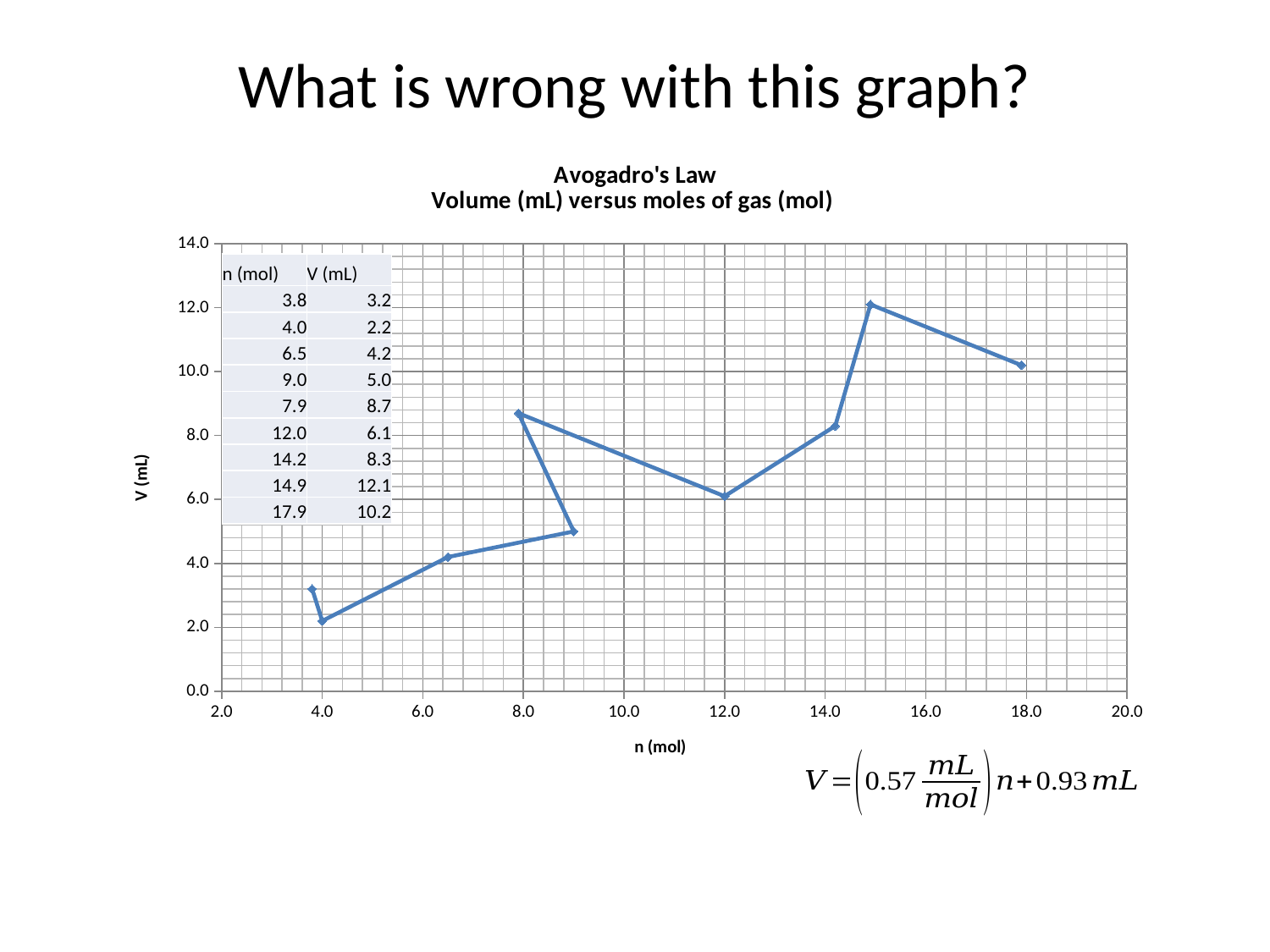
What is the difference in volume between n = 14.9 mol and n = 17.9 mol? 1.9 What type of chart is shown on the slide? line chart How many data points are plotted on the chart? 9 Which has the larger volume, n = 14.2 mol or n = 12.0 mol? n = 14.2 mol What is the label of the vertical axis? V (mL) Is the volume at n = 7.9 mol greater or less than 8.0 mL? greater What is the volume V (mL) at n = 14.9 mol? 12.1 What is the volume V (mL) at n = 7.9 mol? 8.7 At which value of n (mol) is the volume lowest? 4.0 What is the title of the chart? Avogadro's Law Volume (mL) versus moles of gas (mol) At which value of n (mol) is the volume highest? 14.9 What is the volume V (mL) at n = 17.9 mol? 10.2